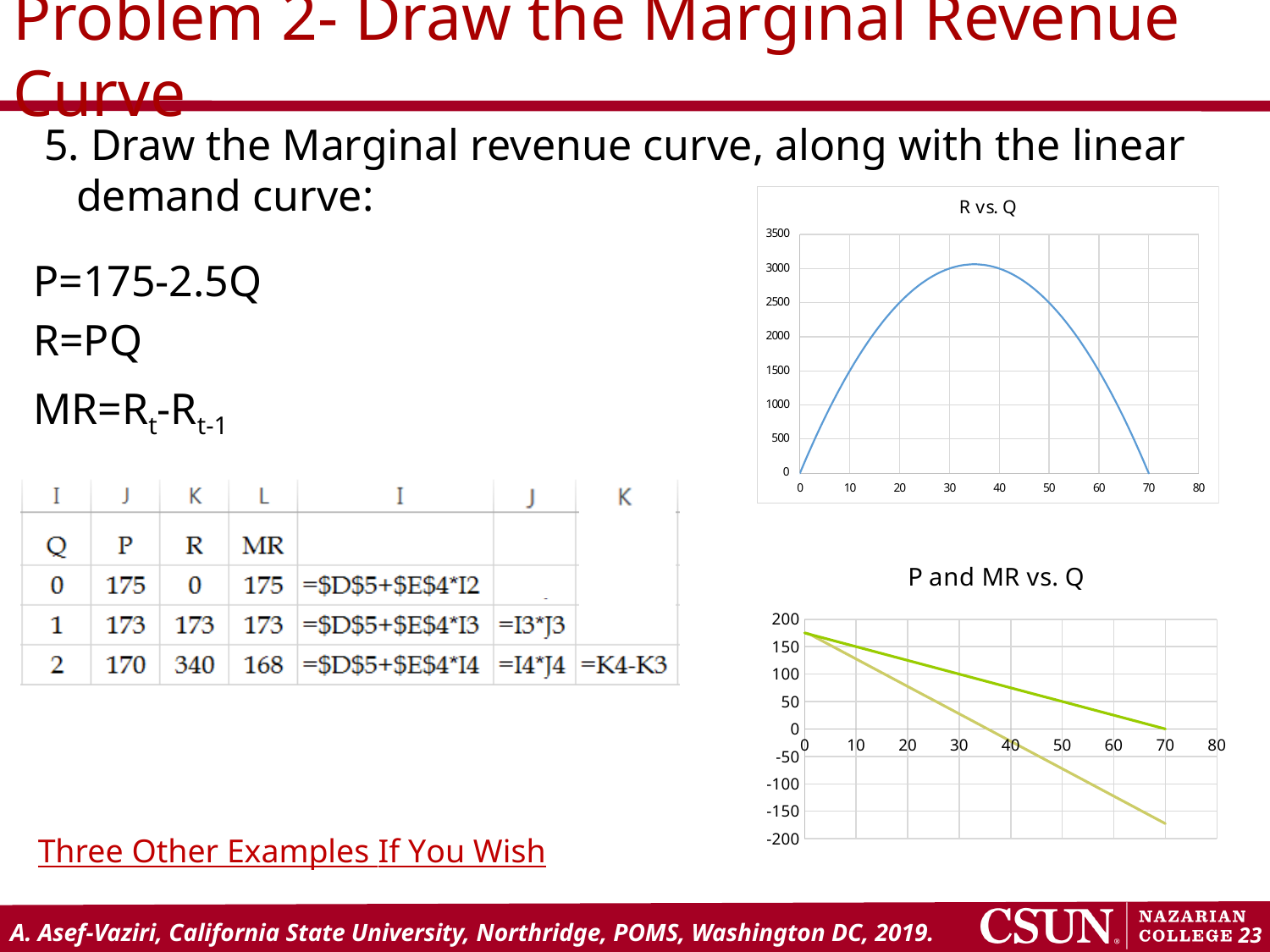
In the "P and MR vs. Q" chart, at Q=40, which line is higher, the upper (P) line or the lower (MR) line? the upper (P) line What is the title of the upper chart on the slide? R vs. Q In the "R vs. Q" chart, does R rise or fall as Q increases from 0 to 30? rise In the "R vs. Q" chart, does R rise or fall as Q increases from 40 to 70? fall In the "R vs. Q" chart, at what value of Q does the curve return to 0 on the right side? 70 In the "P and MR vs. Q" chart, do the lines rise or fall as Q increases? fall What kind of chart is the "R vs. Q" chart? line chart In the "R vs. Q" chart, is the value of R at Q=30 greater or less than 2500? greater In the "P and MR vs. Q" chart, is the value of the lower (MR) line at Q=60 greater or less than -100? less What kind of chart is the "P and MR vs. Q" chart? line chart How many lines are plotted in the "P and MR vs. Q" chart? 2 In the "R vs. Q" chart, is the peak value of R greater or less than 3500? less